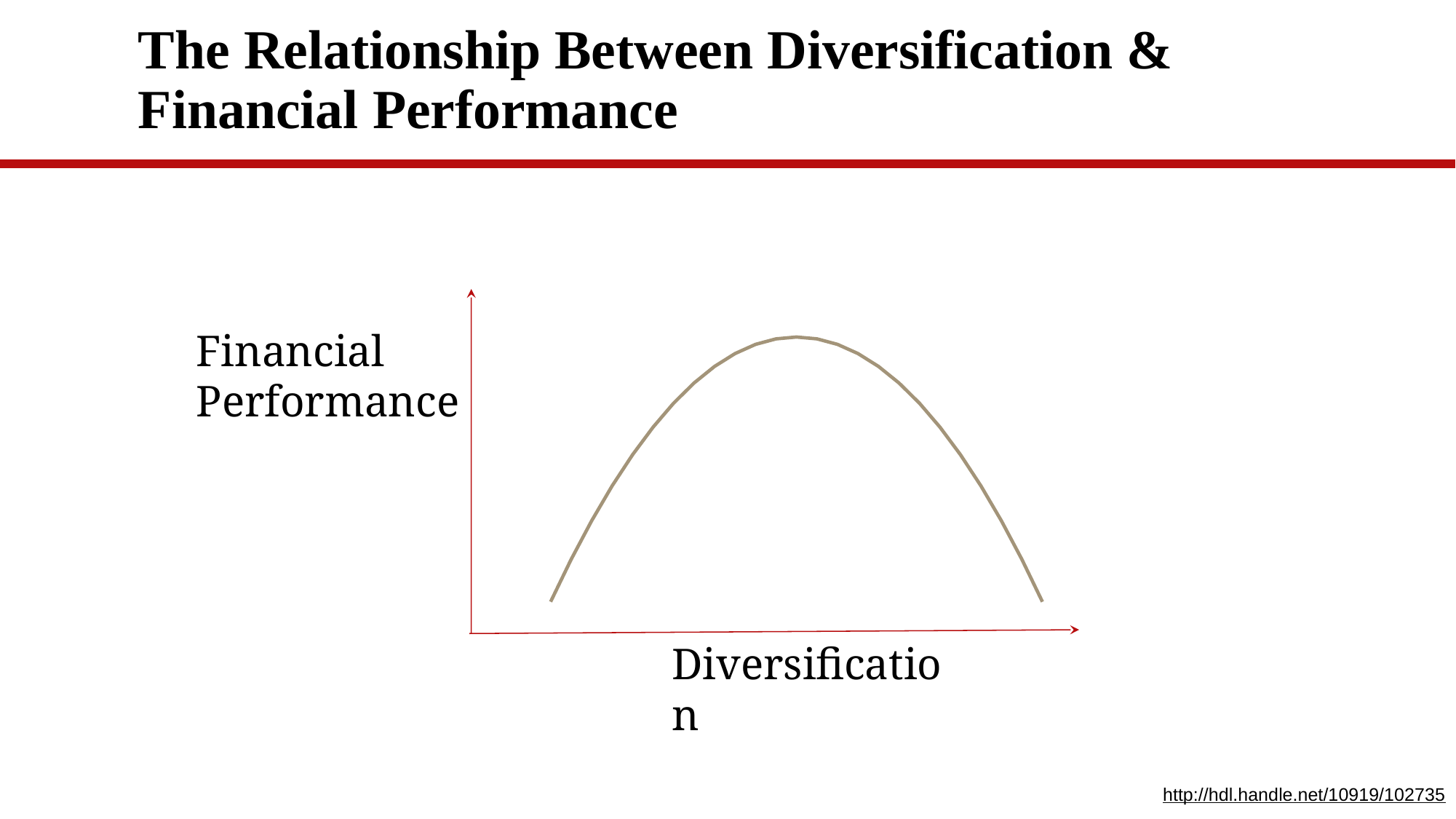
What kind of chart is shown on the slide? line chart Is the peak of the curve located near the left end, the middle, or the right end of the diversification axis? the middle Does the curve rise or fall on the left half of the chart, as diversification first increases? rises How does financial performance change as diversification increases along the x axis? rises then falls Does the curve rise or fall on the right half of the chart, at high levels of diversification? falls How many curves are plotted on the chart? 1 What is the label on the vertical axis of the chart? Financial Performance What is the label on the horizontal axis of the chart? Diversification